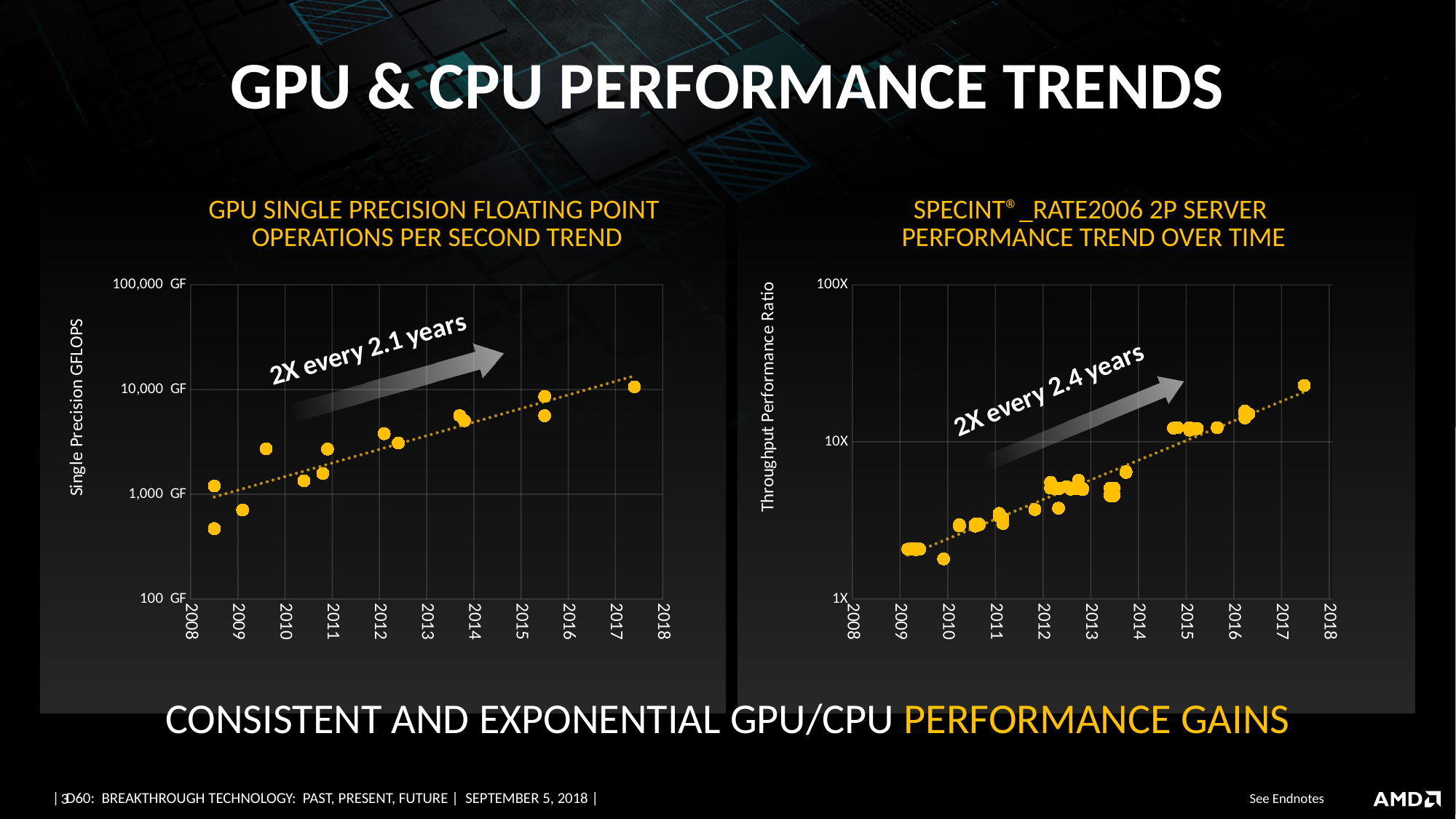
In the SPECint_rate2006 2P Server Performance Trend Over Time chart, is the value for the point plotted in 2017 greater or less than 10X? greater What doubling rate is annotated on the GPU Single Precision Floating Point Operations Per Second Trend chart? 2X every 2.1 years In the SPECint_rate2006 2P Server Performance Trend Over Time chart, do the plotted values rise or fall over time? rise In the GPU Single Precision Floating Point Operations Per Second Trend chart, is the value for the lowest point plotted in 2008 greater or less than 1,000 GF? less In the GPU Single Precision Floating Point Operations Per Second Trend chart, do the plotted values rise or fall from 2008 to 2018? rise In the GPU Single Precision Floating Point Operations Per Second Trend chart, is the value for the point plotted in 2012 greater or less than 1,000 GF? greater What kind of chart is the GPU Single Precision Floating Point Operations Per Second Trend chart on the left? scatter chart How many charts are shown on the slide? 2 What doubling rate is annotated on the SPECint_rate2006 2P Server Performance Trend Over Time chart? 2X every 2.4 years What kind of chart is the SPECint_rate2006 2P Server Performance Trend Over Time chart on the right? scatter chart